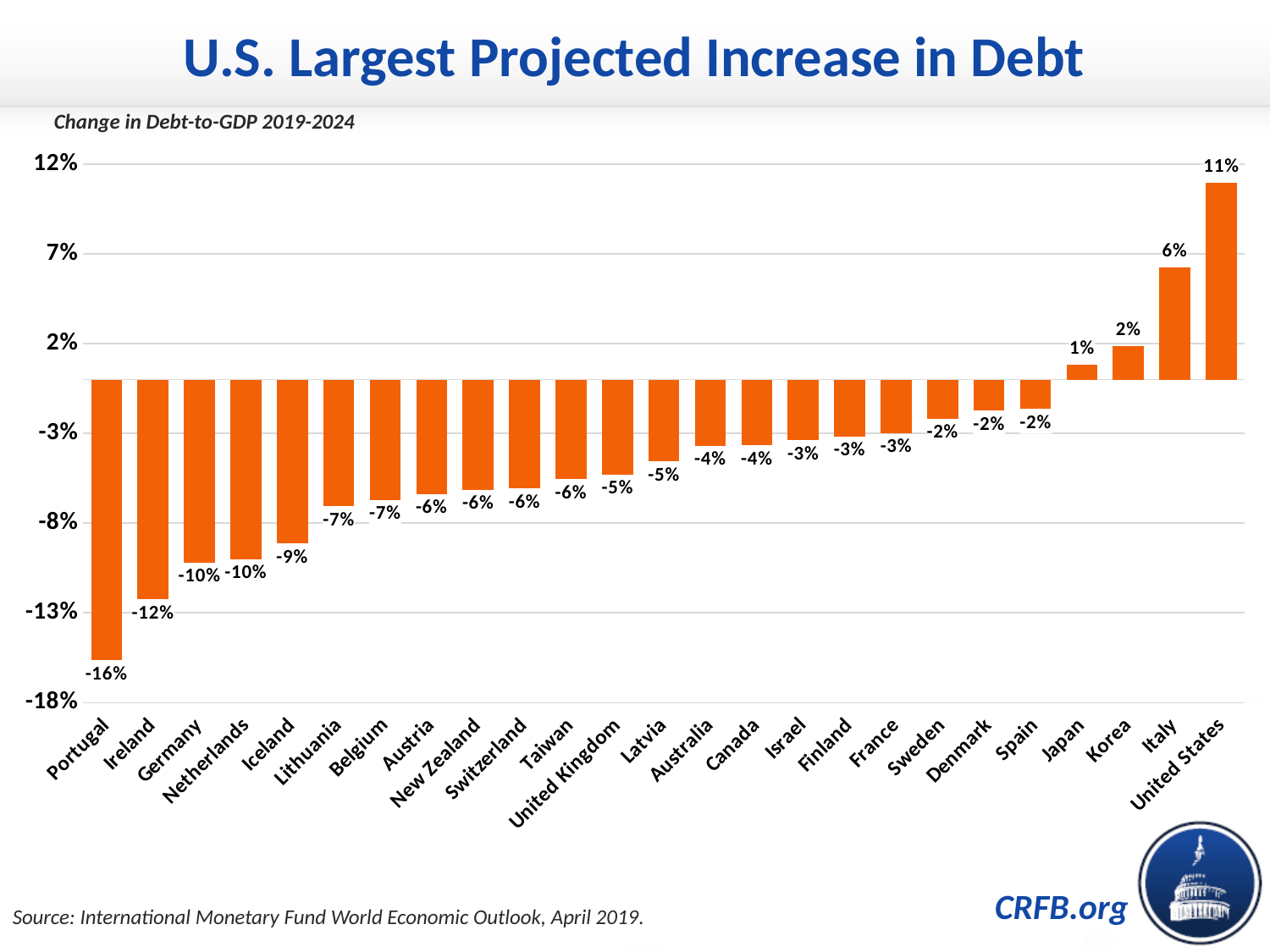
What is the change in debt-to-GDP for Japan? 1% Which country has the largest projected increase in debt-to-GDP? United States What kind of chart is shown on the slide? Bar chart What is the difference between the United States value and the Italy value? 5% Do the values rise or fall moving from left to right along the x axis? Rise What is the difference between the Ireland value and the Portugal value? 4% Which has a larger change in debt-to-GDP, Korea or Japan? Korea How many countries are shown in the chart? 25 What is the change in debt-to-GDP for Italy? 6% What is the change in debt-to-GDP for the United States? 11% What is the change in debt-to-GDP for Portugal? -16% Which country has the lowest change in debt-to-GDP? Portugal